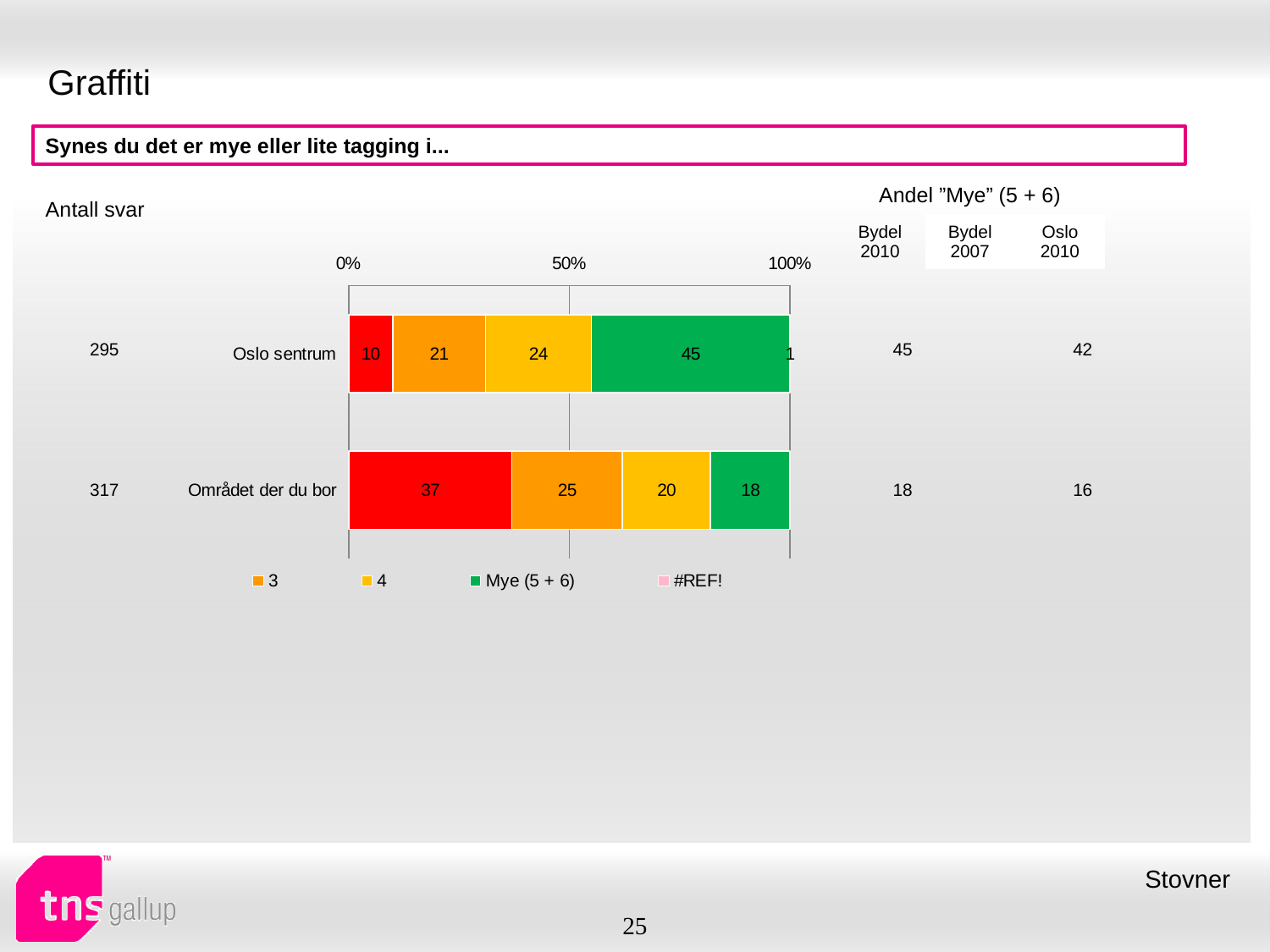
What is the difference between the Mye (5 + 6) values for Oslo sentrum and Området der du bor? 27 What is the value of the series labelled 4 for Området der du bor? 20 What is the difference between the values of the series labelled 3 for Området der du bor and Oslo sentrum? 4 What is the value of the Mye (5 + 6) segment for Oslo sentrum? 45 What kind of chart is shown on the slide? Stacked bar chart What is the value of the series labelled 4 for Oslo sentrum? 24 What is the value of the series labelled 3 for Området der du bor? 25 What is the value of the Mye (5 + 6) segment for Området der du bor? 18 How many categories are shown in the chart? 2 Which category has the larger Mye (5 + 6) value, Oslo sentrum or Området der du bor? Oslo sentrum What is the value of the series labelled 3 for Oslo sentrum? 21 What is the highest tick label shown on the chart's percentage axis? 100%